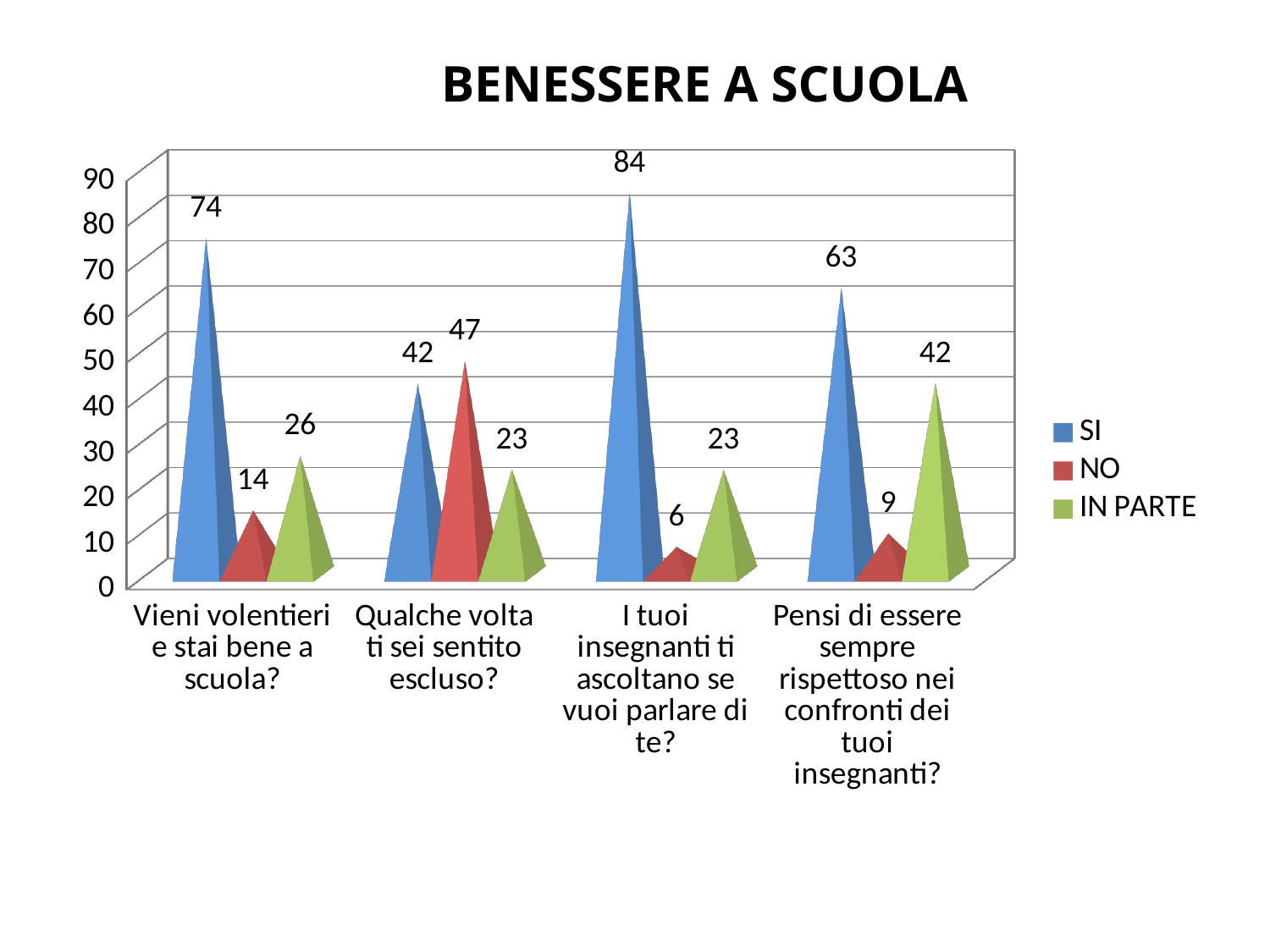
Which question has the highest SI value? I tuoi insegnanti ti ascoltano se vuoi parlare di te? How many questions (categories) are shown on the x axis? 4 What kind of chart is this? bar chart For "Qualche volta ti sei sentito escluso?", which is larger, SI or NO? NO How many series does the legend list? 3 What is the NO value for "Qualche volta ti sei sentito escluso?"? 47 Which question has the lowest NO value? I tuoi insegnanti ti ascoltano se vuoi parlare di te? What is the title of the chart? BENESSERE A SCUOLA What is the IN PARTE value for "Pensi di essere sempre rispettoso nei confronti dei tuoi insegnanti?"? 42 What is the difference between the SI and NO values for "Vieni volentieri e stai bene a scuola?"? 60 Which colour represents the IN PARTE series? green What is the SI value for "Vieni volentieri e stai bene a scuola?"? 74